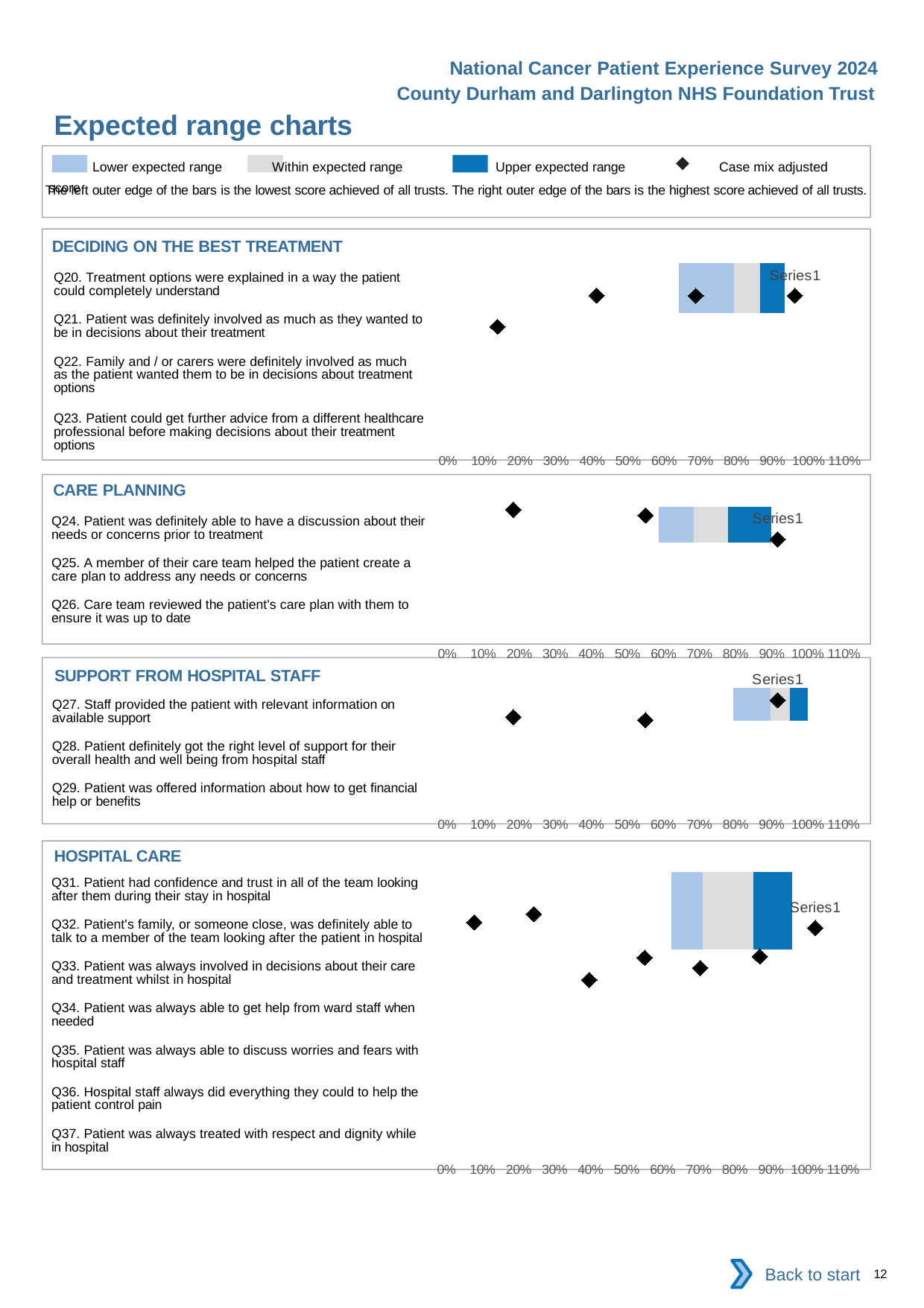
How many entries does the legend at the top of the slide list? 4 How many questions (categories) are listed in the 'SUPPORT FROM HOSPITAL STAFF' chart? 3 What kind of chart is used in the 'DECIDING ON THE BEST TREATMENT' section? Bar chart What is the lowest tick label on the x axis of the 'CARE PLANNING' chart? 0% Which legend entry is shown with the dark blue colour? Upper expected range How many charts are shown on the slide? 4 How many questions (categories) are listed in the 'DECIDING ON THE BEST TREATMENT' chart? 4 What is the highest tick label on the x axis of the 'HOSPITAL CARE' chart? 110%